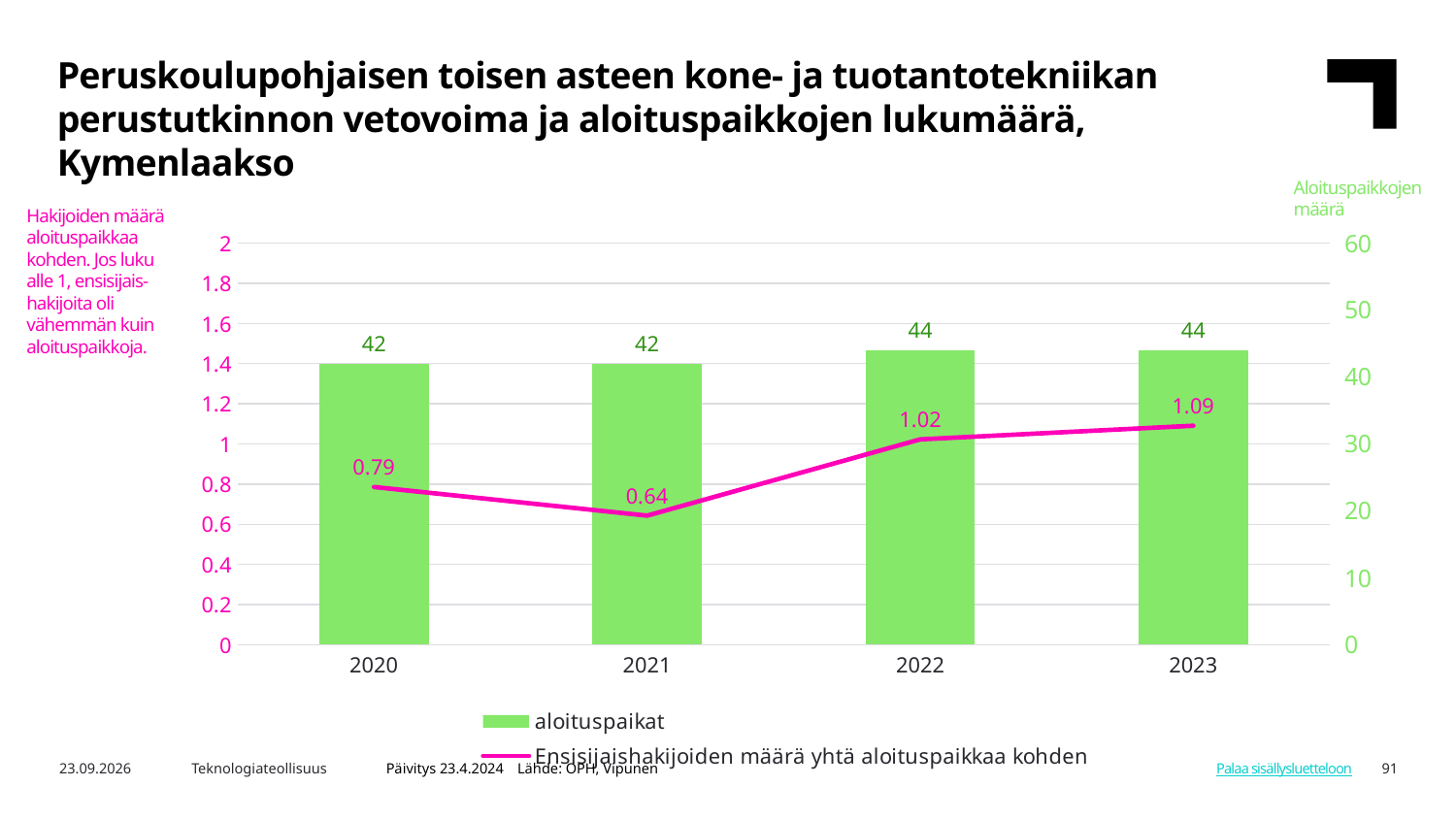
In which year is Ensisijaishakijoiden määrä yhtä aloituspaikkaa kohden highest? 2023 How many years are shown on the x axis? 4 In which year is Ensisijaishakijoiden määrä yhtä aloituspaikkaa kohden lowest? 2021 Which year has a higher value of Ensisijaishakijoiden määrä yhtä aloituspaikkaa kohden, 2020 or 2022? 2022 What is the value of Ensisijaishakijoiden määrä yhtä aloituspaikkaa kohden for 2023? 1.09 What is the value of Ensisijaishakijoiden määrä yhtä aloituspaikkaa kohden for 2021? 0.64 How many series does the legend list? 2 What is the difference between the aloituspaikat values for 2023 and 2020? 2 What is the difference between the Ensisijaishakijoiden määrä yhtä aloituspaikkaa kohden values for 2022 and 2021? 0.38 What colour are the aloituspaikat bars? Green What is the value of aloituspaikat for 2022? 44 Is the value of Ensisijaishakijoiden määrä yhtä aloituspaikkaa kohden for 2020 greater or less than 1? less